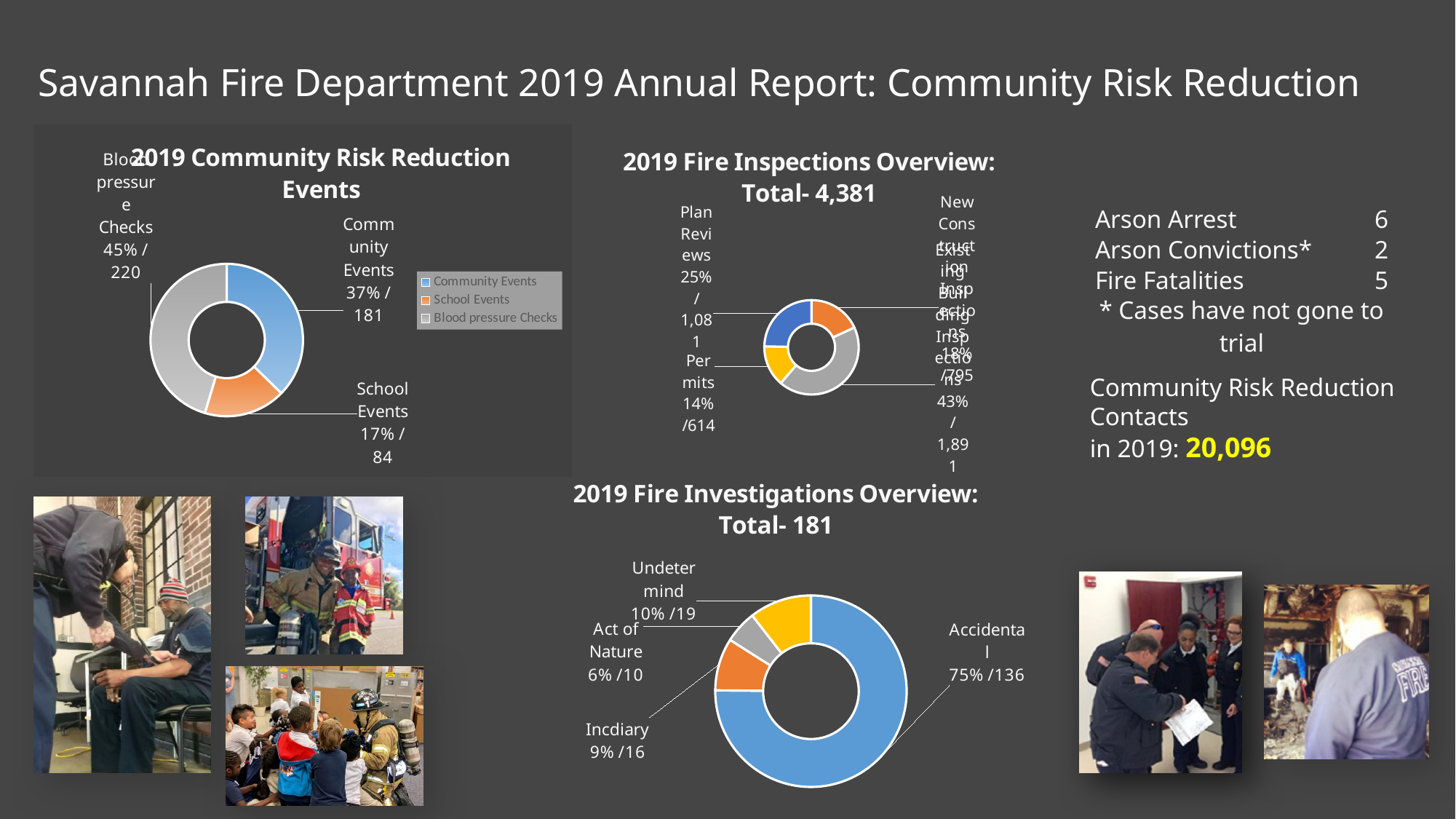
In the '2019 Fire Investigations Overview' chart, which is larger: Undetermined or Incendiary? Undetermined What type of chart is the '2019 Community Risk Reduction Events' chart? Doughnut (pie) chart In the '2019 Community Risk Reduction Events' chart, which category has the largest share? Blood pressure Checks How many entries does the legend of the '2019 Community Risk Reduction Events' chart list? 3 How many categories are shown in the '2019 Fire Investigations Overview' chart? 4 What total is stated in the title of the '2019 Fire Inspections Overview' chart? 4,381 In the '2019 Fire Investigations Overview' chart, what share of investigations was Accidental? 75% In the '2019 Fire Inspections Overview' chart, what is the value shown for Permits? 14% /614 In the '2019 Fire Inspections Overview' chart, what percentage and count are shown for Plan Reviews? 25% / 1,081 In the '2019 Community Risk Reduction Events' chart, what is the difference in count between Blood pressure Checks and Community Events? 39 In the '2019 Community Risk Reduction Events' chart, what is the value shown for School Events? 17% / 84 In the '2019 Fire Investigations Overview' chart, which category has the smallest share? Act of Nature